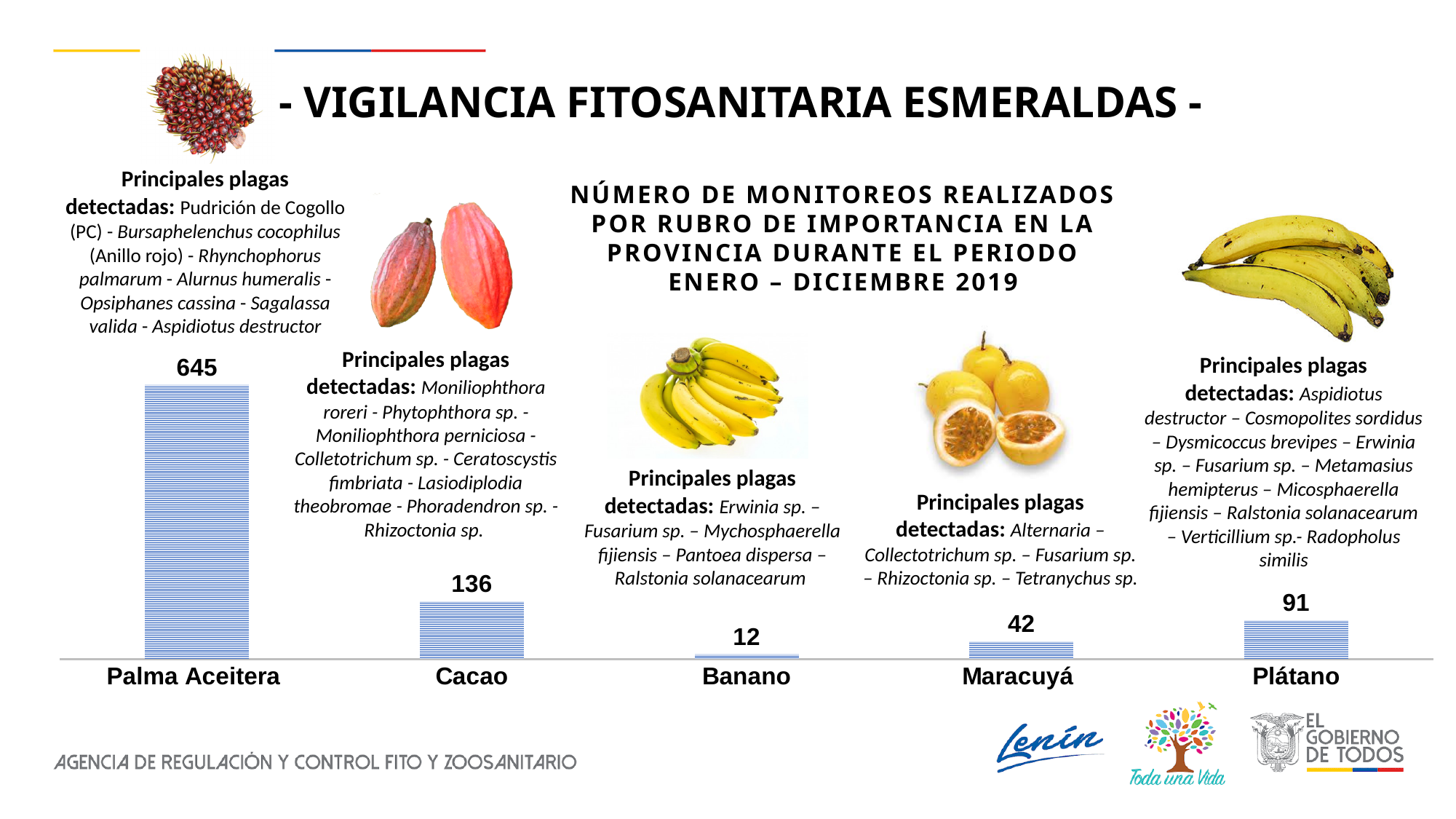
What is the value shown for Cacao? 136 What is the value shown for Banano? 12 How many categories are shown in the chart? 5 How many monitoreos were carried out for Palma Aceitera? 645 What kind of chart is shown on the slide? Bar chart What is the difference between the values for Palma Aceitera and Cacao? 509 Which category has the lowest number of monitoreos? Banano What is the difference between the values for Plátano and Maracuyá? 49 What is the value shown for Plátano? 91 Which category has the highest number of monitoreos? Palma Aceitera Which has a larger value, Cacao or Plátano? Cacao What is the value shown for Maracuyá? 42